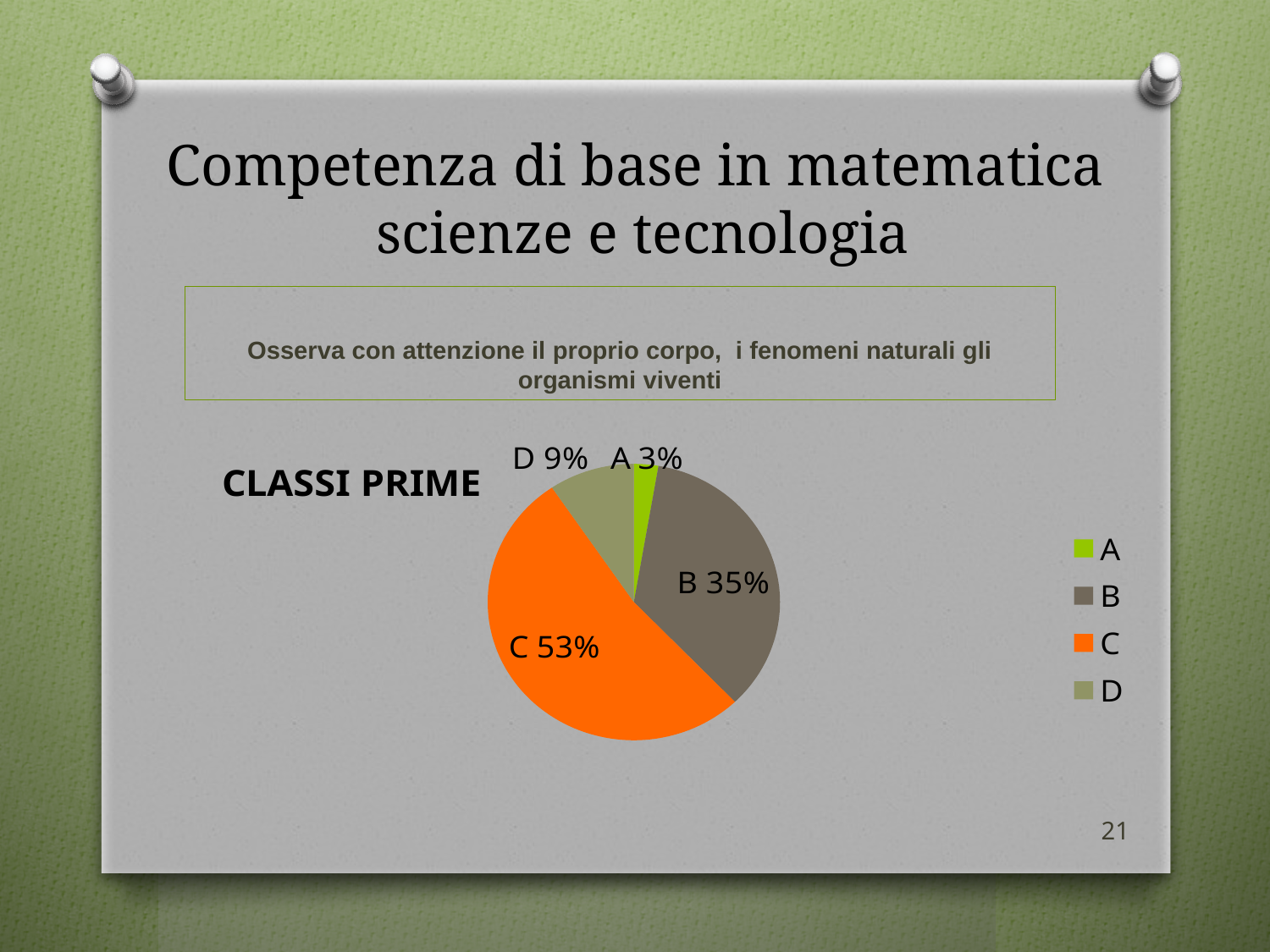
What percentage does slice D represent in the pie chart? 9% What percentage does slice A represent in the pie chart? 3% What percentage does slice B represent in the pie chart? 35% Which category has the smallest share of the pie chart? A What is the difference in percentage points between slice C and slice B? 18 What label appears to the left of the pie chart? CLASSI PRIME How many entries does the legend list? 4 Which is larger, the share for B or the share for D? B Which category has the largest share of the pie chart? C How many slices does the pie chart have? 4 What percentage does slice C represent in the pie chart? 53% What kind of chart is shown on the slide? pie chart